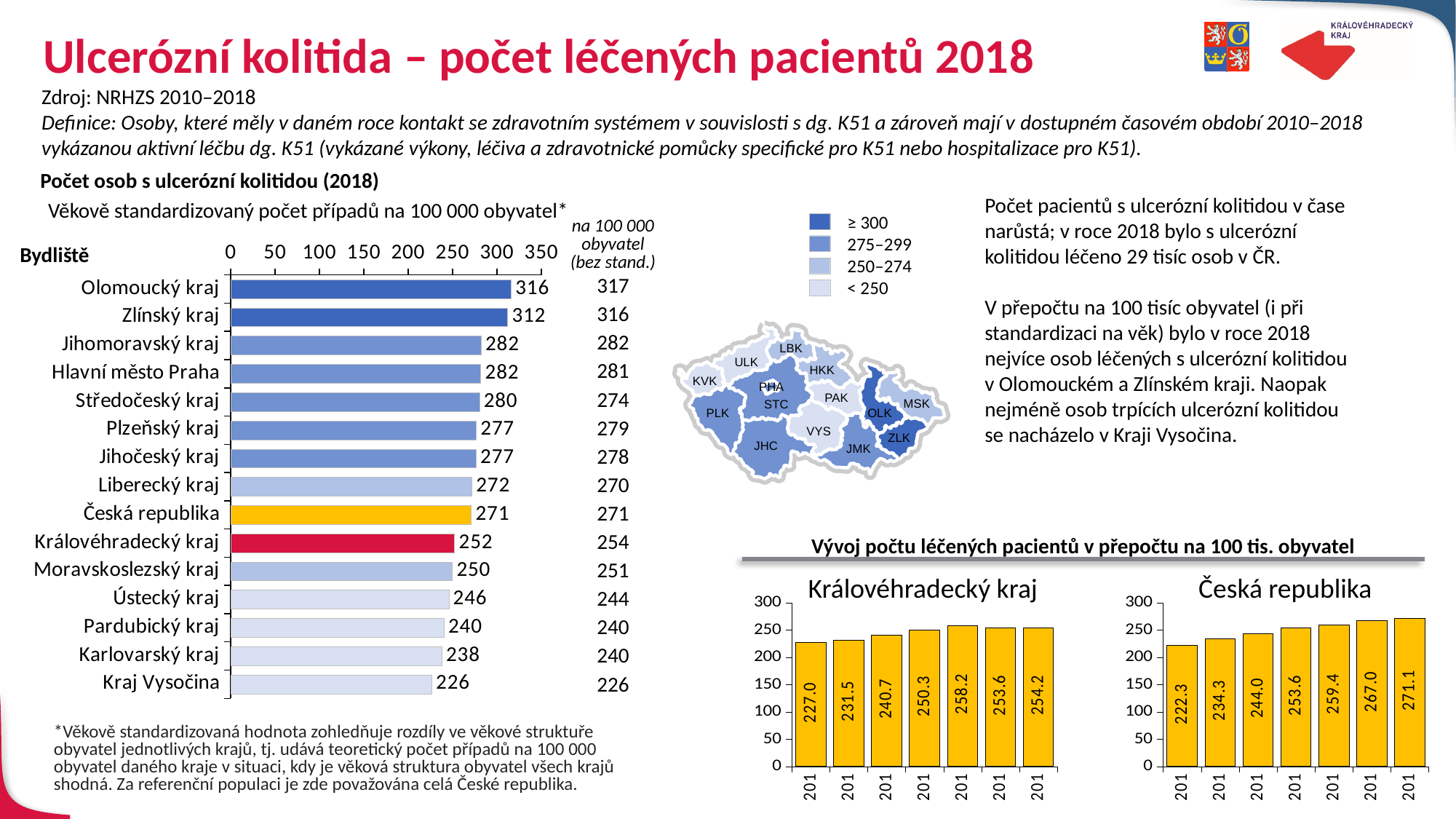
In the bar chart 'Počet osob s ulcerózní kolitidou (2018)', what is the age-standardized value for Olomoucký kraj? 316 What type of chart is 'Počet osob s ulcerózní kolitidou (2018)'? bar chart In the bar chart 'Počet osob s ulcerózní kolitidou (2018)', which region has the lowest age-standardized value? Kraj Vysočina In the 'Královéhradecký kraj' chart at the bottom right, what is the value of the highest bar? 258.2 In the 'Česká republika' chart at the bottom right, what is the value of the last (rightmost) bar? 271.1 In the bar chart 'Počet osob s ulcerózní kolitidou (2018)', which has the larger age-standardized value, Zlínský kraj or Jihomoravský kraj? Zlínský kraj In the bar chart 'Počet osob s ulcerózní kolitidou (2018)', how many bars (regions including Česká republika) are shown? 15 In the bar chart 'Počet osob s ulcerózní kolitidou (2018)', what is the difference between the age-standardized values for Olomoucký kraj and Kraj Vysočina? 90 In the bar chart 'Počet osob s ulcerózní kolitidou (2018)', what colour is the bar for Česká republika? yellow In the bar chart 'Počet osob s ulcerózní kolitidou (2018)', what is the age-standardized value for Královéhradecký kraj? 252 In the 'Česká republika' chart at the bottom right, do the values rise or fall from left to right? rise In the bar chart 'Počet osob s ulcerózní kolitidou (2018)', which region has the highest age-standardized value? Olomoucký kraj